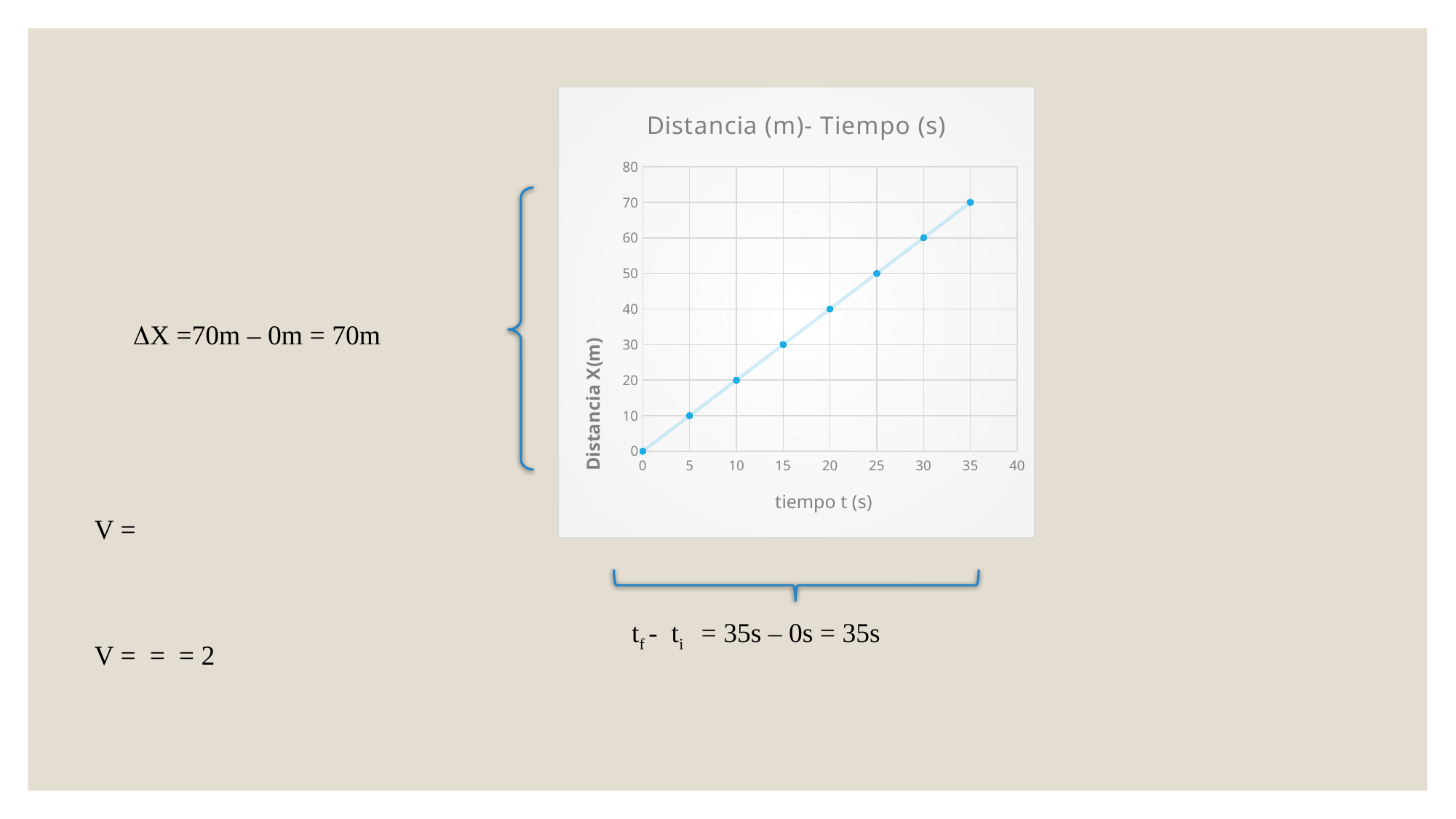
What is the distance X(m) at tiempo t = 20 s? 40 At which time value is the distance lowest? 0 What is the title of the chart? Distancia (m)- Tiempo (s) Which is larger, the distance at t = 15 s or at t = 25 s? t = 25 s What kind of chart is shown on the slide? scatter chart with a line At which time value is the distance highest? 35 What is the difference in distance between t = 30 s and t = 10 s? 40 What is the distance X(m) at tiempo t = 35 s? 70 How many data points are plotted on the chart? 8 Do the distance values rise or fall as time increases along the x axis? rise What is the distance X(m) at tiempo t = 5 s? 10 What is the label of the x axis? tiempo t (s)